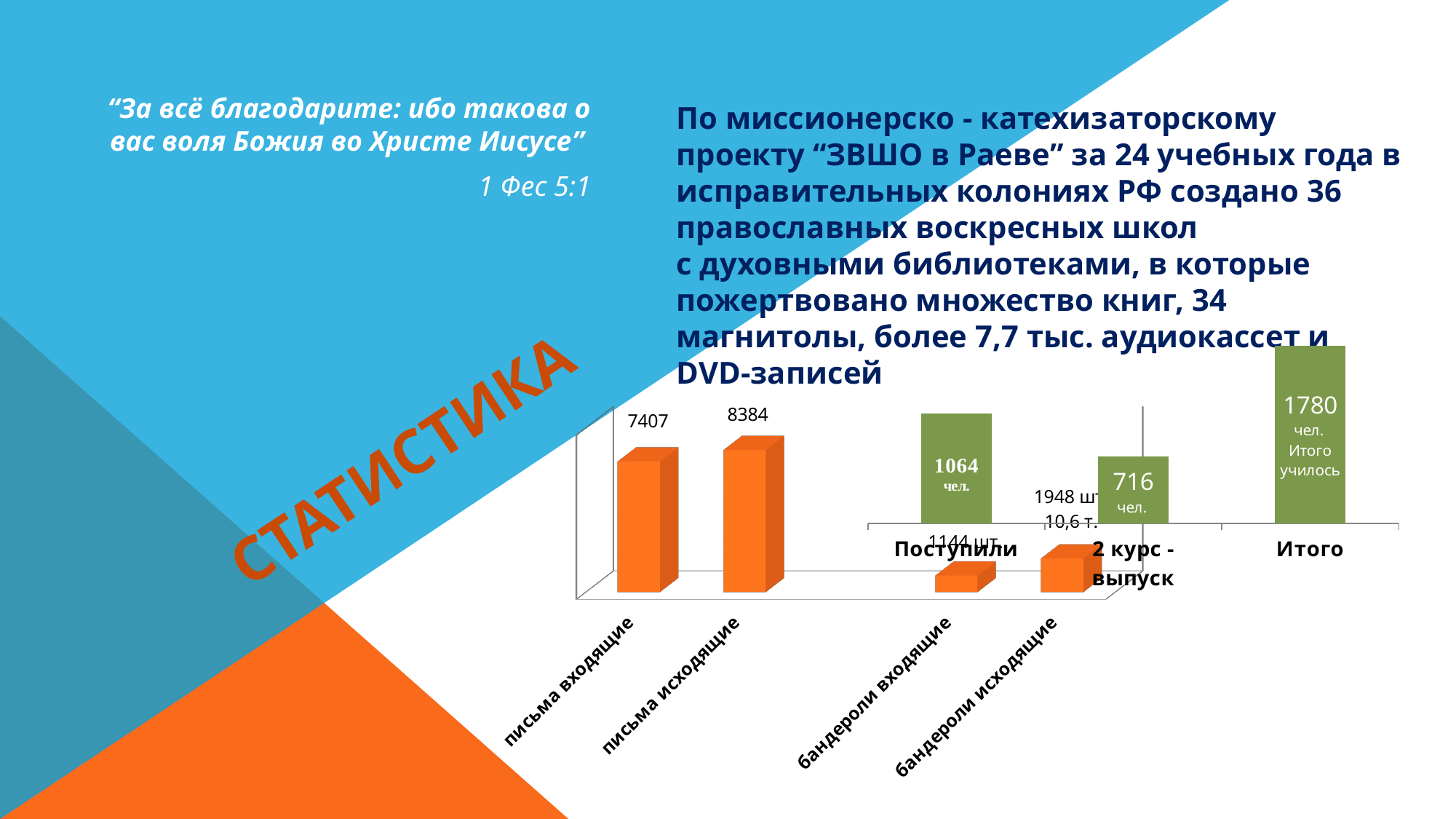
On the orange bar chart, what is the value for письма входящие? 7407 On the green bar chart, what is the value for 2 курс - выпуск? 716 чел. On the orange bar chart, which category has the lowest value? бандероли входящие On the orange bar chart, which is larger: бандероли входящие or бандероли исходящие? бандероли исходящие On the green bar chart, which category has the lowest value? 2 курс - выпуск What kind of chart is the green chart on the slide? bar chart On the green bar chart, what is the value for Итого? 1780 чел. On the green bar chart, what is the value for Поступили? 1064 чел. On the orange bar chart, which category has the highest value? письма исходящие On the orange bar chart, what is the value for письма исходящие? 8384 How many categories does the orange bar chart show? 4 On the orange bar chart, what is the difference between письма исходящие and письма входящие? 977